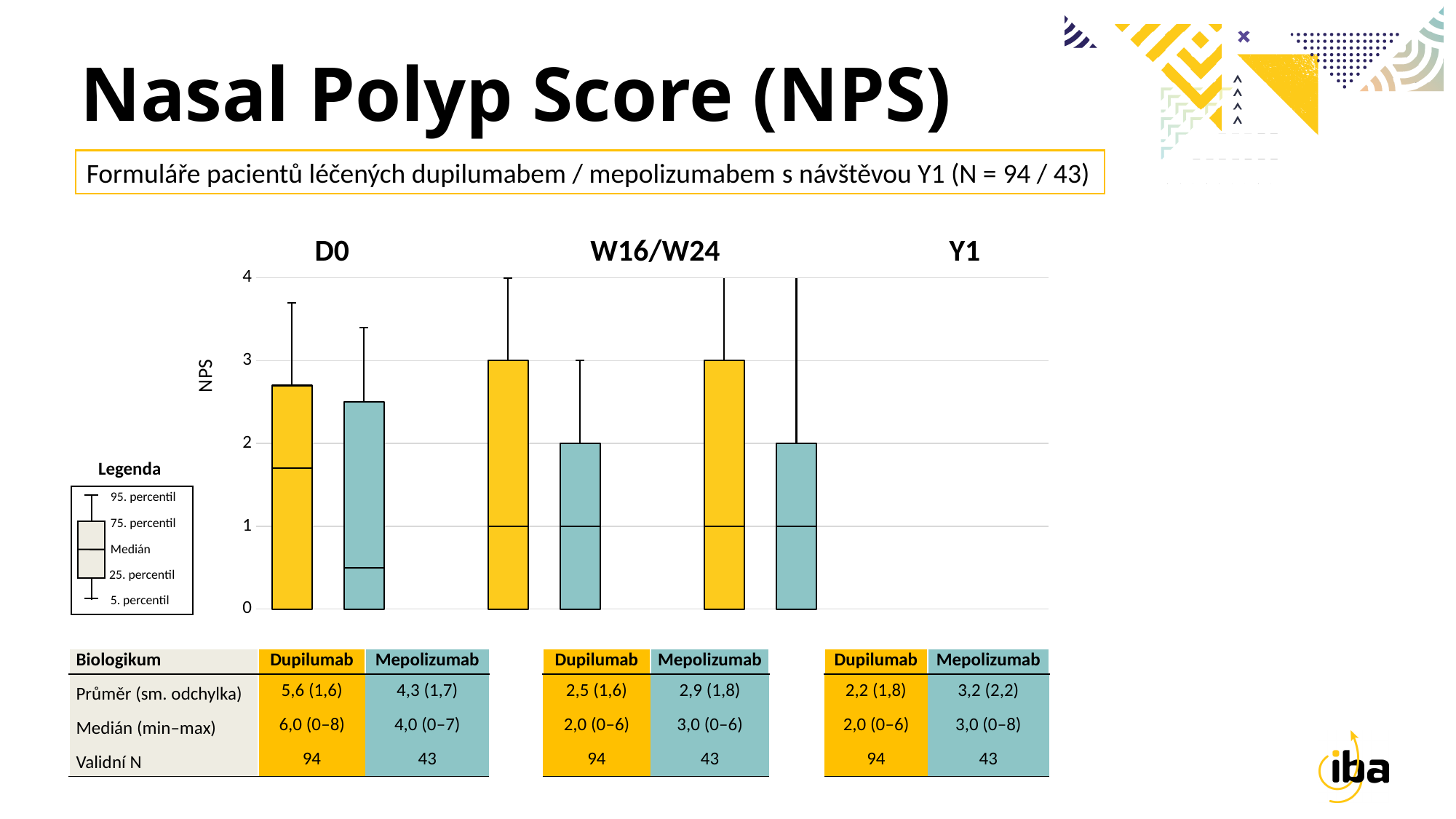
Is the median line for Mepolizumab at D0 greater or less than 1? less Does the mean NPS for Dupilumab rise or fall from D0 to Y1? fall At D0, which treatment has the higher mean NPS in the table, Dupilumab or Mepolizumab? Dupilumab What is the mean (standard deviation) NPS for Dupilumab at D0 according to the table? 5,6 (1,6) What is the valid N for Mepolizumab at W16/W24? 43 What colour are the boxes for Dupilumab in the chart? yellow What kind of chart is shown on the slide? box plot How many time points are shown along the x axis of the chart? 3 What is the difference between the mean NPS of Mepolizumab and Dupilumab at Y1 in the table? 1,0 How many treatment groups (biologics) are compared in the chart? 2 What is the median (min–max) NPS for Mepolizumab at Y1 according to the table? 3,0 (0–8) Is the 75th percentile (top of the box) for Dupilumab at D0 greater or less than 2? greater